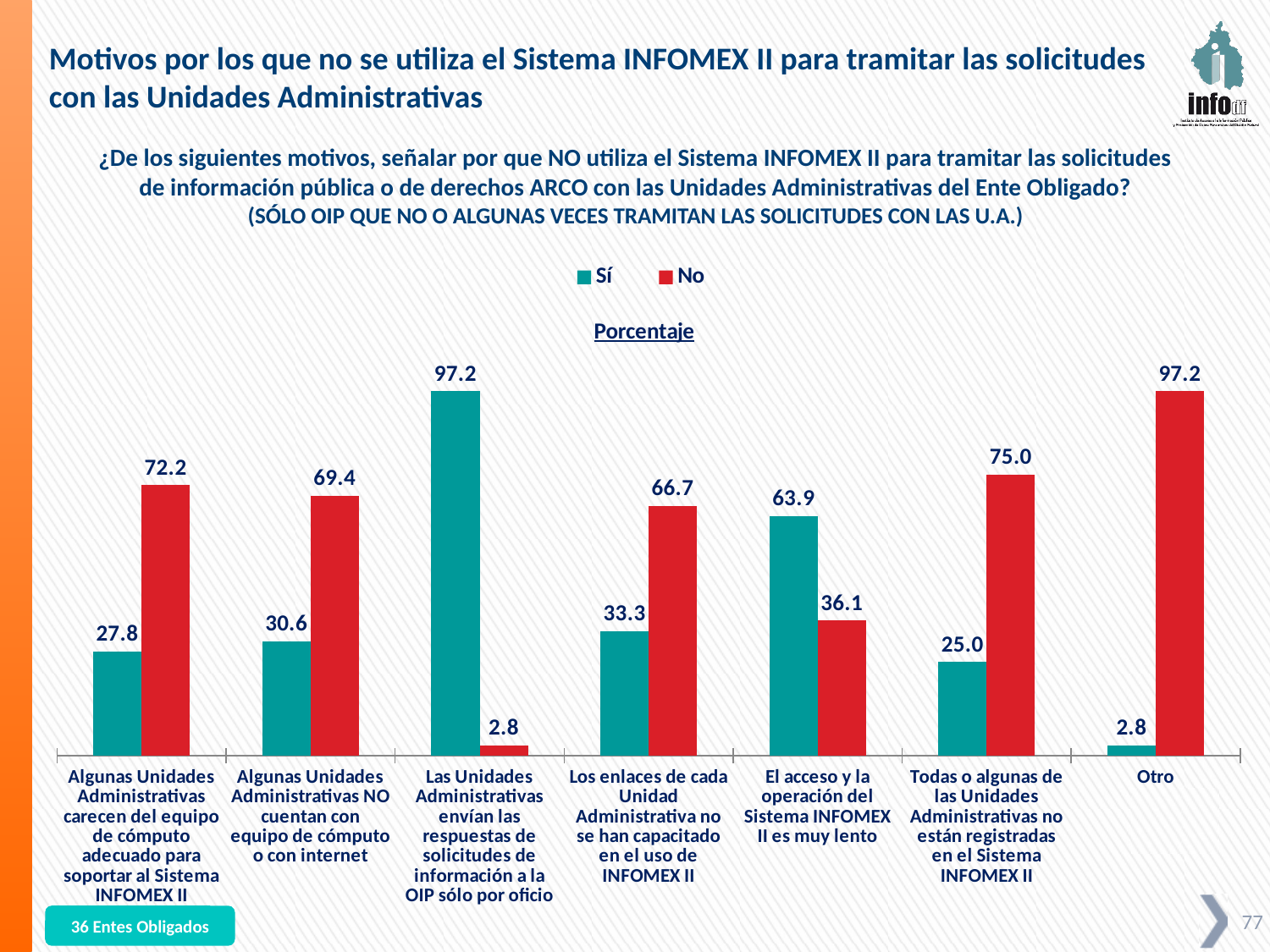
What is the 'Sí' value for 'El acceso y la operación del Sistema INFOMEX II es muy lento'? 63.9 What is the 'No' value for 'Otro'? 97.2 How many series does the legend list? 2 What colour represents the 'No' series in the chart? Red Which category has the lowest 'Sí' value? Otro What is the 'Sí' value for 'Todas o algunas de las Unidades Administrativas no están registradas en el Sistema INFOMEX II'? 25.0 What is the difference between the 'No' and 'Sí' values for 'Algunas Unidades Administrativas NO cuentan con equipo de cómputo o con internet'? 38.8 What is the 'No' value for 'Algunas Unidades Administrativas carecen del equipo de cómputo adecuado para soportar al Sistema INFOMEX II'? 72.2 How many categories are shown on the x axis? 7 What type of chart is shown on the slide? Bar chart For 'Los enlaces de cada Unidad Administrativa no se han capacitado en el uso de INFOMEX II', which is larger, the 'Sí' value or the 'No' value? No Which category has the highest 'Sí' value? Las Unidades Administrativas envían las respuestas de solicitudes de información a la OIP sólo por oficio